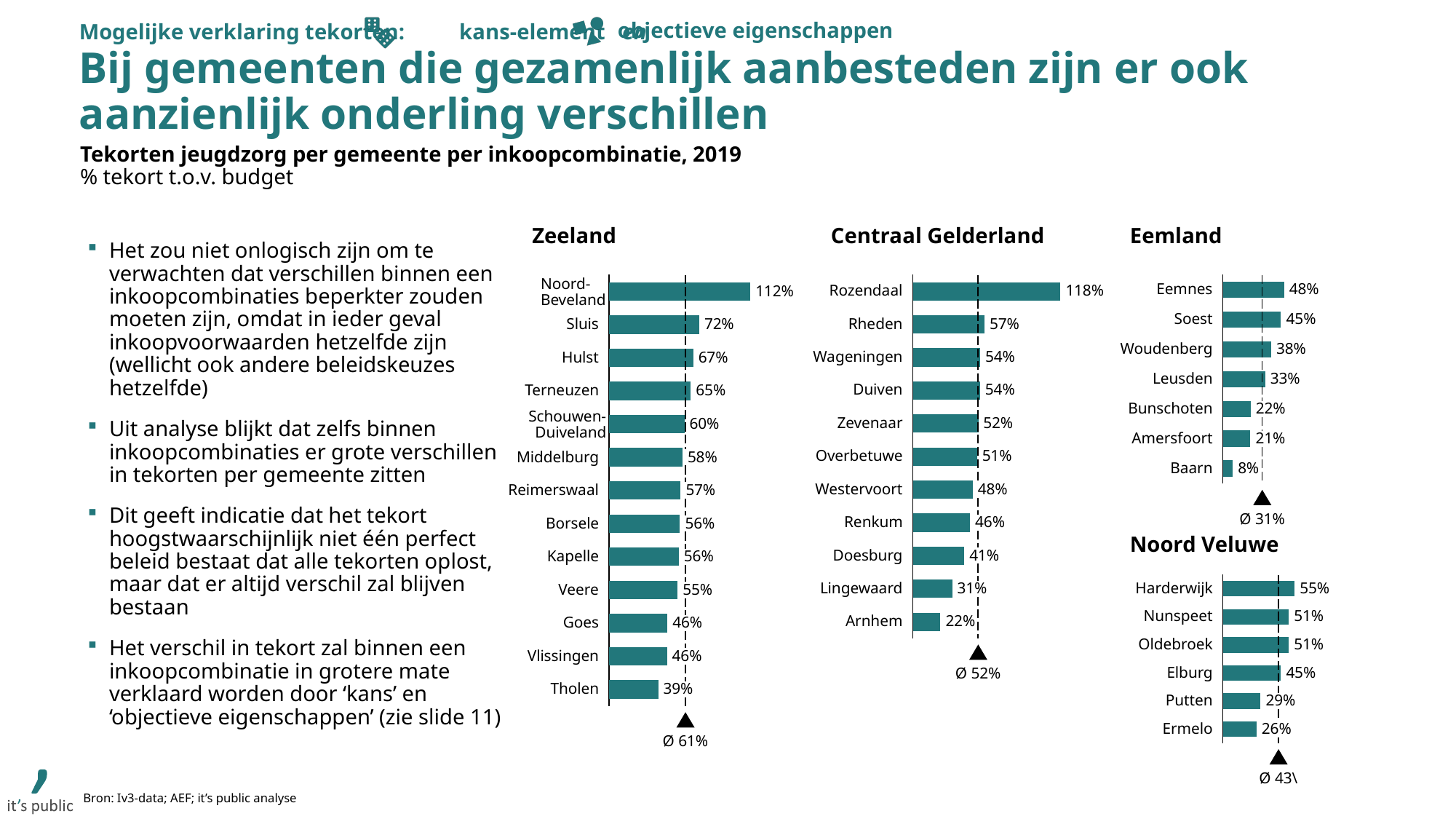
What average value is marked below the Zeeland chart? Ø 61% In the Noord Veluwe chart, what is the difference between the values for Harderwijk and Ermelo? 29% In the Eemland chart, which municipality has the lowest value? Baarn How many municipalities are shown in the Centraal Gelderland chart? 11 In the Zeeland chart, which is larger: the value for Hulst or the value for Tholen? Hulst In the Centraal Gelderland chart, which municipality has the highest value? Rozendaal In the Centraal Gelderland chart, what is the value for Arnhem? 22% In the Noord Veluwe chart, what is the value for Elburg? 45% In the Eemland chart, what is the difference between the values for Eemnes and Soest? 3% In the Zeeland chart, what is the value for Sluis? 72% What kind of chart is the Eemland chart? Bar chart How many municipalities are shown in the Noord Veluwe chart? 6